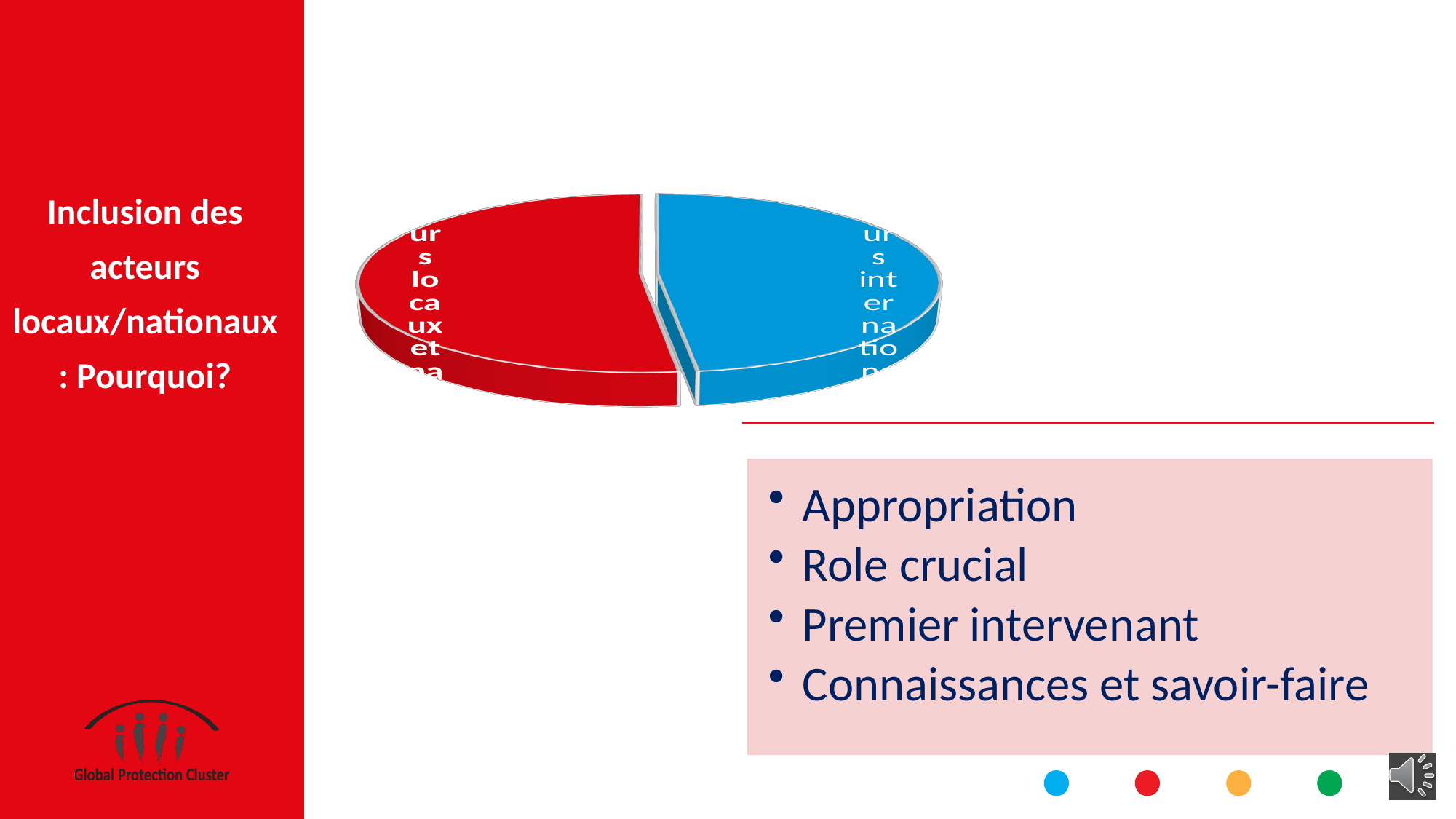
Which slice of the pie chart is larger, the red one or the blue one? the red one What colour is the slice on the left side of the pie chart? red What colour is the slice on the right side of the pie chart? blue How many slices does the pie chart have? 2 What kind of chart is shown on the slide? pie chart